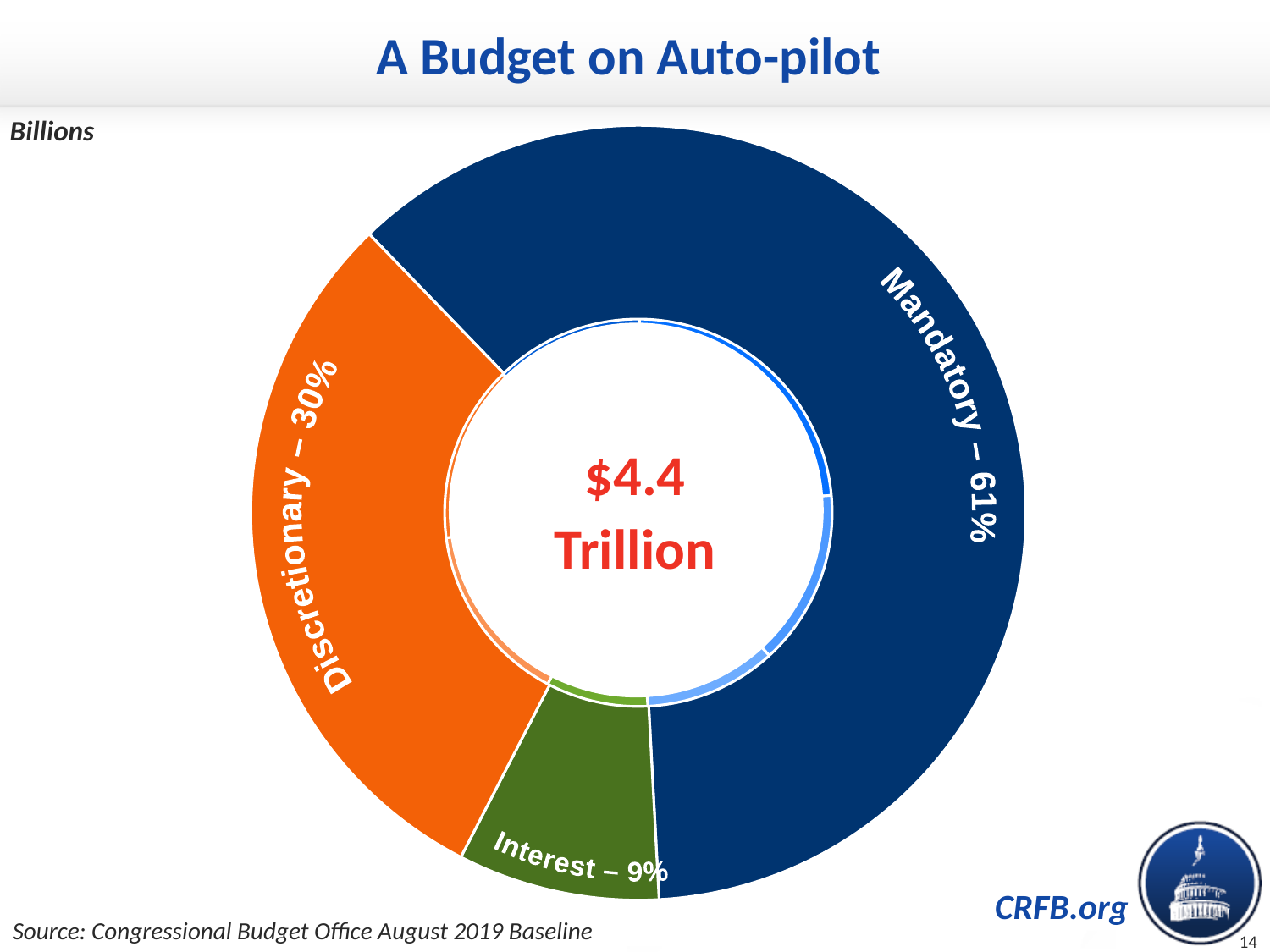
Which category has the largest share of the budget? Mandatory Which is larger, the Discretionary share or the Interest share? Discretionary How many percentage points larger is the Mandatory share than the Discretionary share? 31 What is the title of the chart? A Budget on Auto-pilot What share of the budget is Mandatory spending? 61% What kind of chart is shown on the slide? Pie chart (donut) What share of the budget is Discretionary spending? 30% Which category has the smallest share of the budget? Interest What share of the budget is Interest? 9% What total amount is shown in the centre of the chart? $4.4 Trillion How many categories does the chart show? 3 How many percentage points larger is the Discretionary share than the Interest share? 21